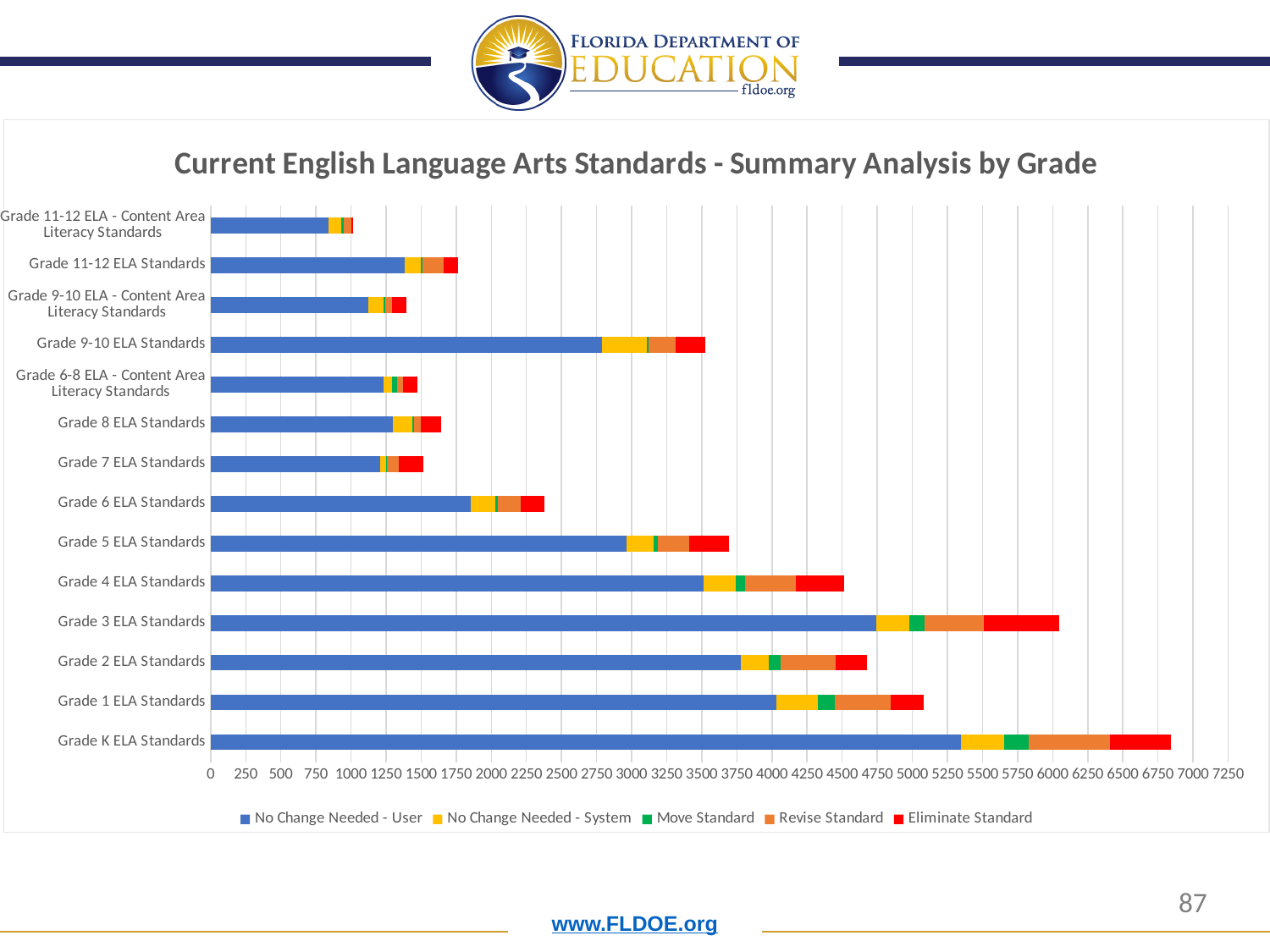
Which has the longer total bar, Grade 3 ELA Standards or Grade 1 ELA Standards? Grade 3 ELA Standards How many grade categories are plotted on the chart? 14 How many series does the legend list? 5 What is the title of the chart? Current English Language Arts Standards - Summary Analysis by Grade Which has the longer total bar, Grade 6 ELA Standards or Grade 8 ELA Standards? Grade 6 ELA Standards Is the total bar length for Grade 3 ELA Standards greater or less than 5750? greater Which grade category has the longest total bar? Grade K ELA Standards Is the total bar length for Grade 2 ELA Standards greater or less than 5000? less Which grade category has the shortest total bar? Grade 11-12 ELA - Content Area Literacy Standards Is the total bar length for Grade K ELA Standards greater or less than 6500? greater What kind of chart is shown on the slide? Stacked bar chart